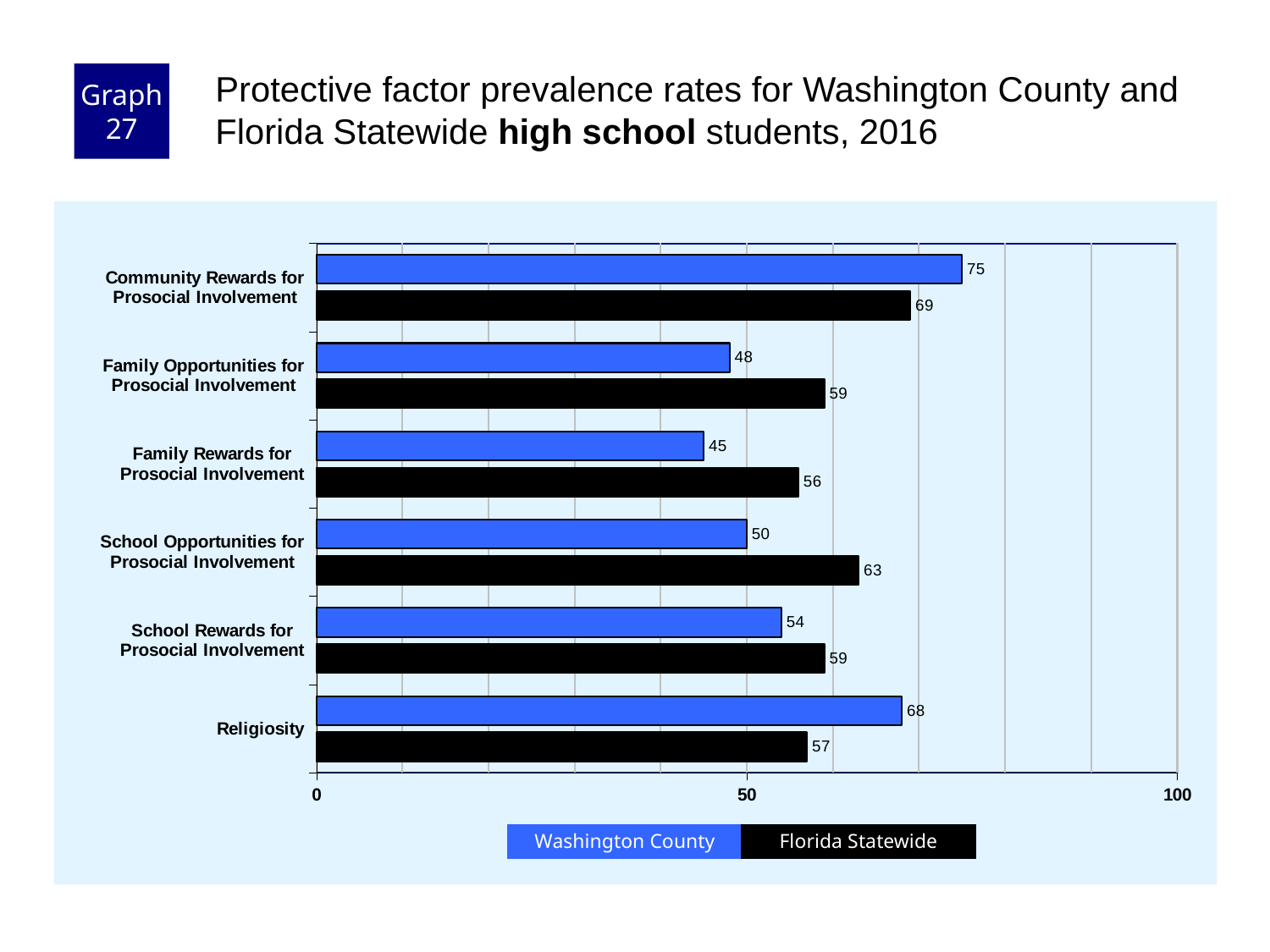
What is the Florida Statewide value for School Opportunities for Prosocial Involvement? 63 Is the Florida Statewide value for Community Rewards for Prosocial Involvement greater or less than 50? greater What kind of chart is shown on the slide? Bar chart How many categories are shown on the chart? 6 For Religiosity, which is larger: the Washington County value or the Florida Statewide value? Washington County Which category has the highest Washington County value? Community Rewards for Prosocial Involvement What is the Washington County value for Community Rewards for Prosocial Involvement? 75 What is the Washington County value for Religiosity? 68 Which category has the lowest Washington County value? Family Rewards for Prosocial Involvement What is the difference between the Florida Statewide and Washington County values for Family Opportunities for Prosocial Involvement? 11 How many series does the legend list? 2 Which category has the lowest Florida Statewide value? Family Rewards for Prosocial Involvement